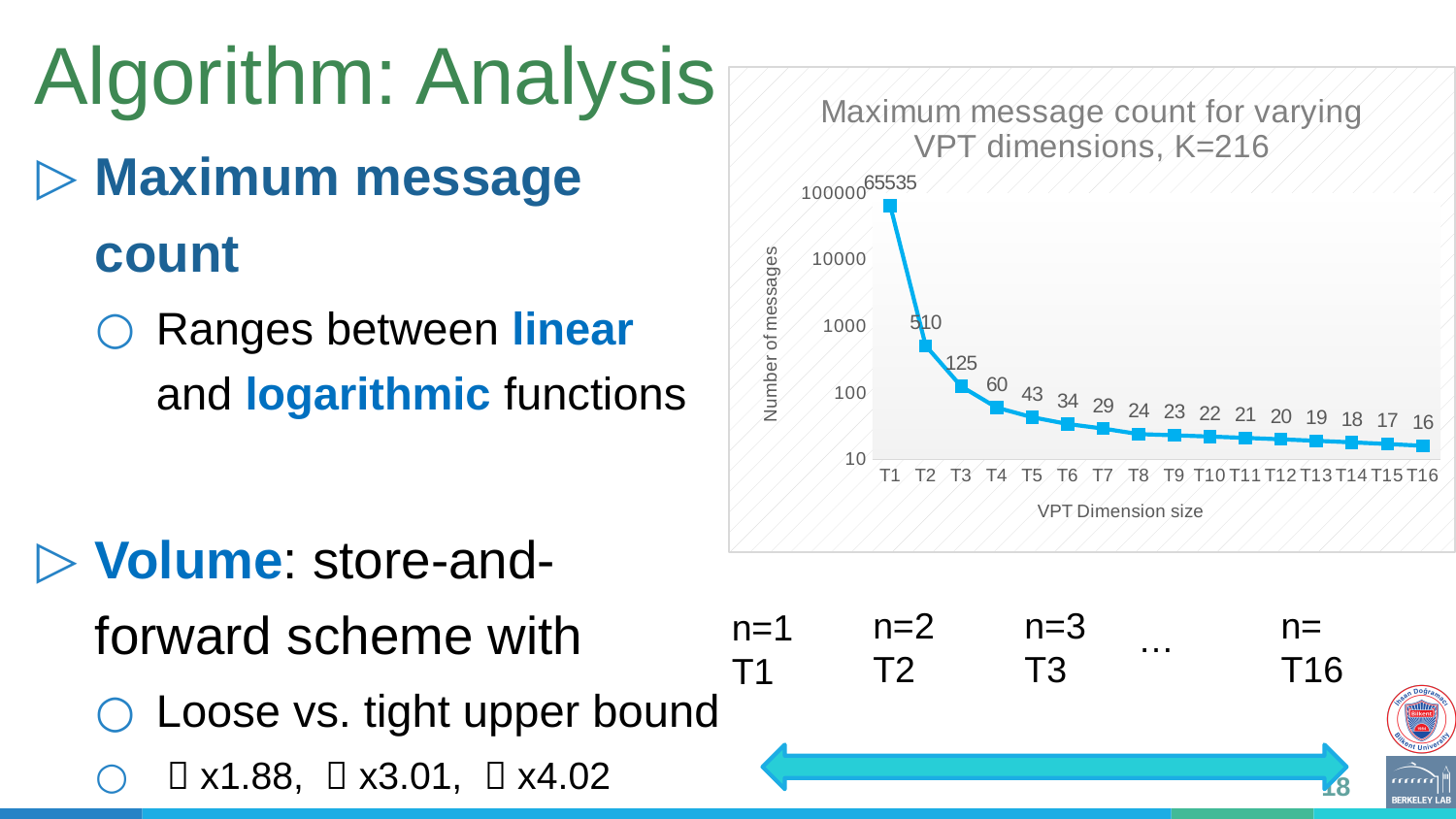
Which VPT dimension size has the lowest maximum message count? T16 What is the number of messages shown for T8? 24 What is the difference between the values for T2 and T3? 385 What is the title of the chart? Maximum message count for varying VPT dimensions, K=216 How many VPT dimension sizes are plotted on the x axis? 16 What kind of chart is shown on the slide? Line chart Which VPT dimension size has the highest maximum message count? T1 What is the value plotted for T3? 125 What is the maximum message count for VPT dimension T1? 65535 What is the difference between the values for T4 and T5? 17 Do the values rise or fall as the VPT dimension size increases from T1 to T16? Fall Which has a larger value, T6 or T10? T6